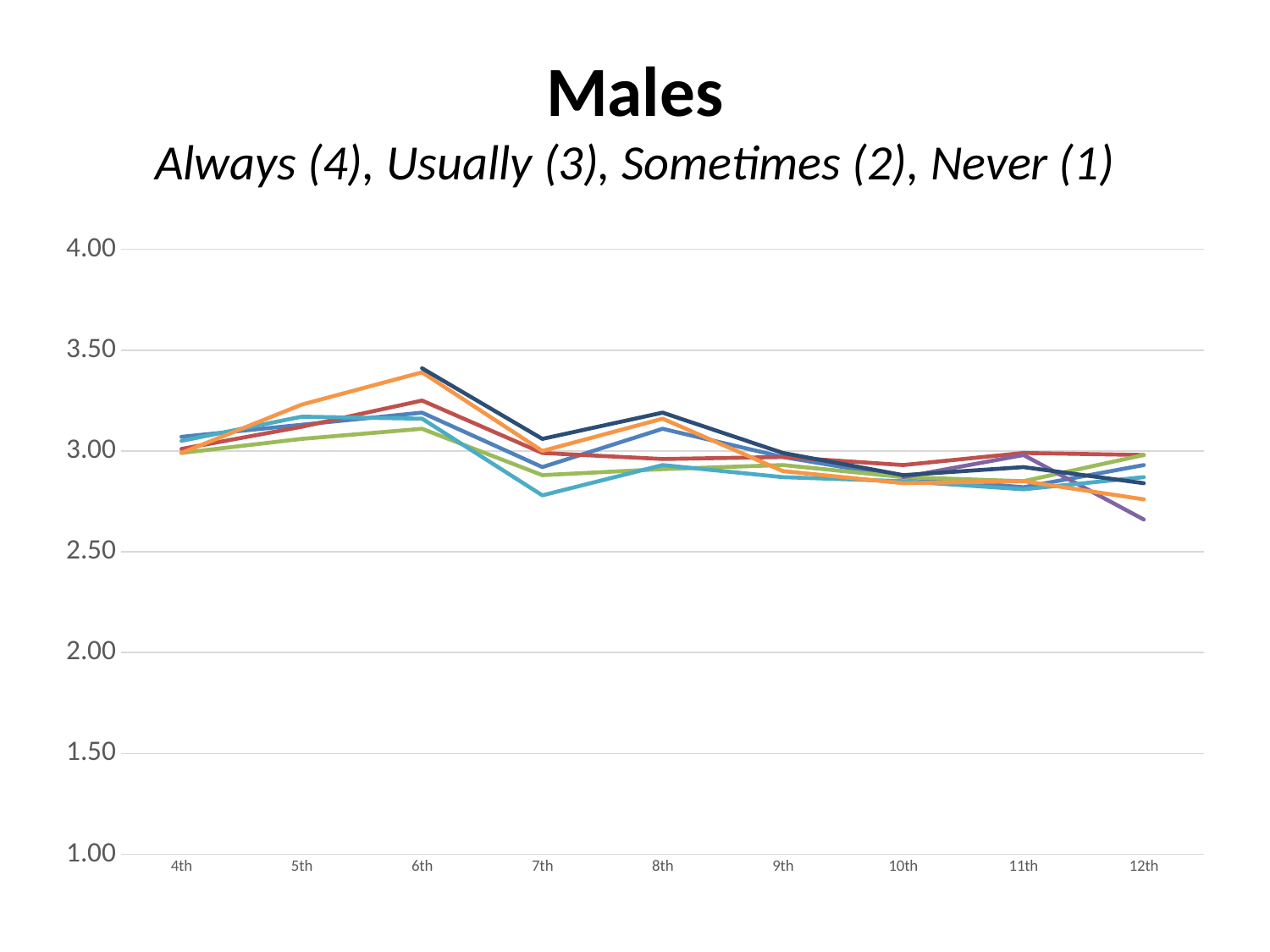
At which grade does the orange line reach its highest value? 6th Is the value of the dark navy line at 6th greater or less than 3.50? less At which grade does the purple line reach its lowest value? 12th What is the subtitle shown under the chart title? Always (4), Usually (3), Sometimes (2), Never (1) What kind of chart is shown on the slide? line chart Is the value of the orange line at 6th greater or less than 3.00? greater Does the orange line rise or fall from 4th to 6th? rise Do the values generally rise or fall from 6th to 12th? fall Is the value of the cyan line at 7th greater or less than 3.00? less How many grade levels are shown along the x axis? 9 What is the title of the chart? Males